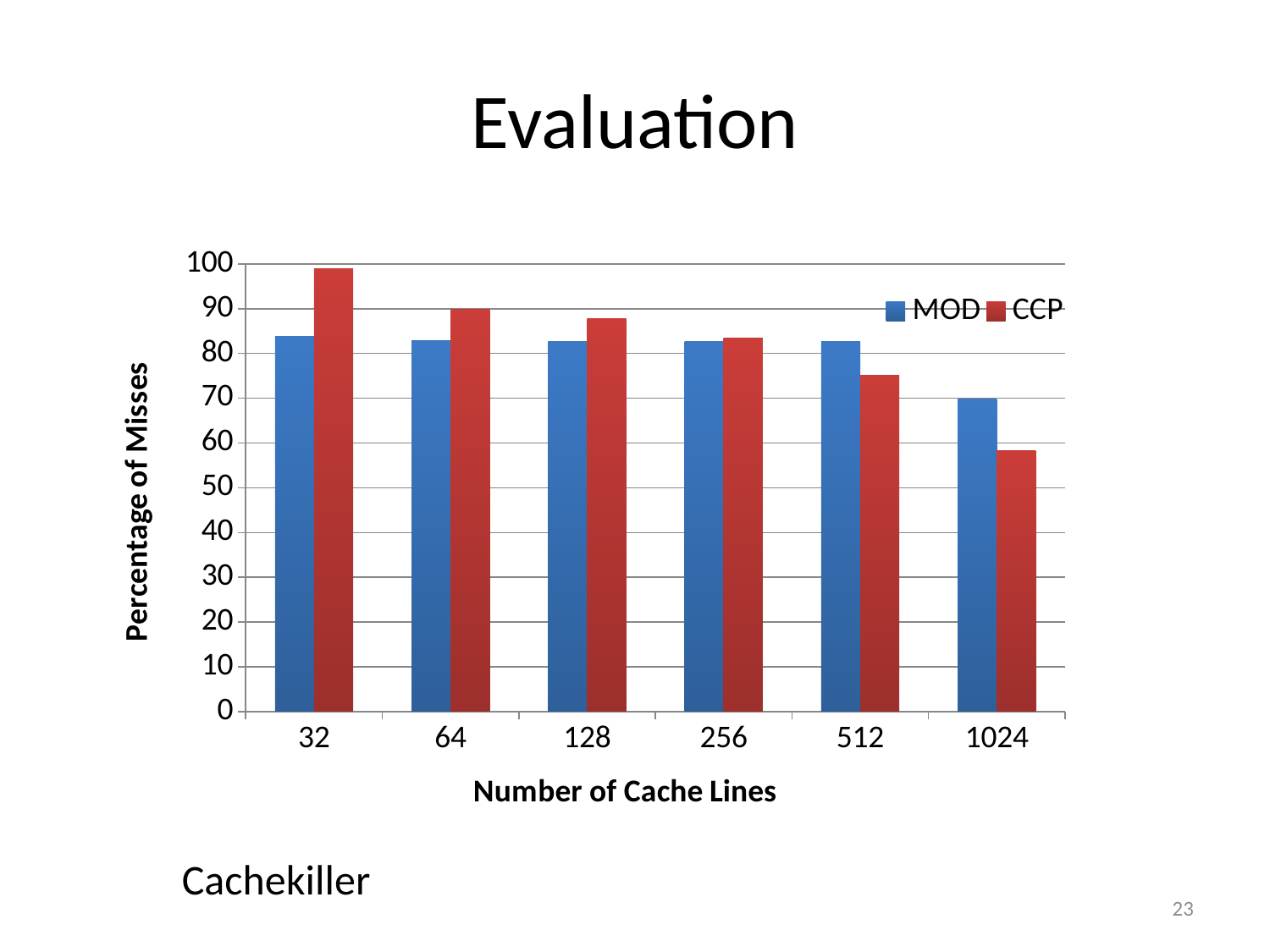
Is the CCP value for 1024 cache lines greater or less than 60? less Which number of cache lines has the highest CCP value? 32 At 1024 cache lines, which series has the larger value, MOD or CCP? MOD Is the CCP value for 32 cache lines greater or less than 90? greater How many cache-line categories are shown on the x axis? 6 How many series does the legend list? 2 Do the CCP values rise or fall as the number of cache lines increases? fall What is the label of the y axis? Percentage of Misses At 32 cache lines, which series has the larger value, MOD or CCP? CCP Which number of cache lines has the lowest CCP value? 1024 Which number of cache lines has the lowest MOD value? 1024 What kind of chart is shown on the slide? bar chart